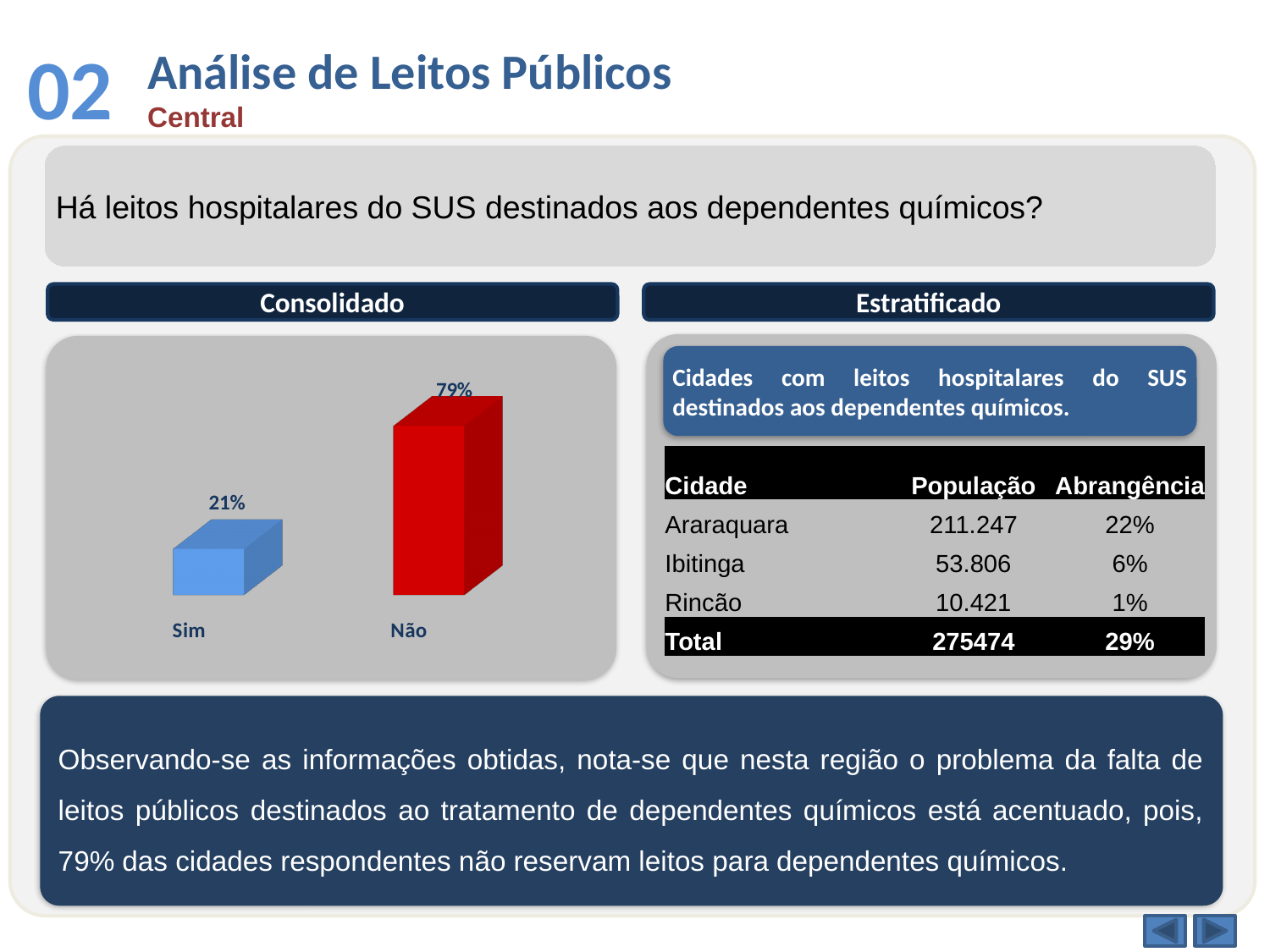
What kind of chart is shown under Consolidado? Bar chart What is the value for Não in the Consolidado chart? 79% Which is larger in the Consolidado chart, Sim or Não? Não Which category has the lowest value in the Consolidado chart? Sim How many categories are shown in the Consolidado chart? 2 What colour is the bar for Não in the Consolidado chart? Red Which category has the highest value in the Consolidado chart? Não What colour is the bar for Sim in the Consolidado chart? Blue What is the value for Sim in the Consolidado chart? 21% What is the difference between the values for Não and Sim in the Consolidado chart? 58%